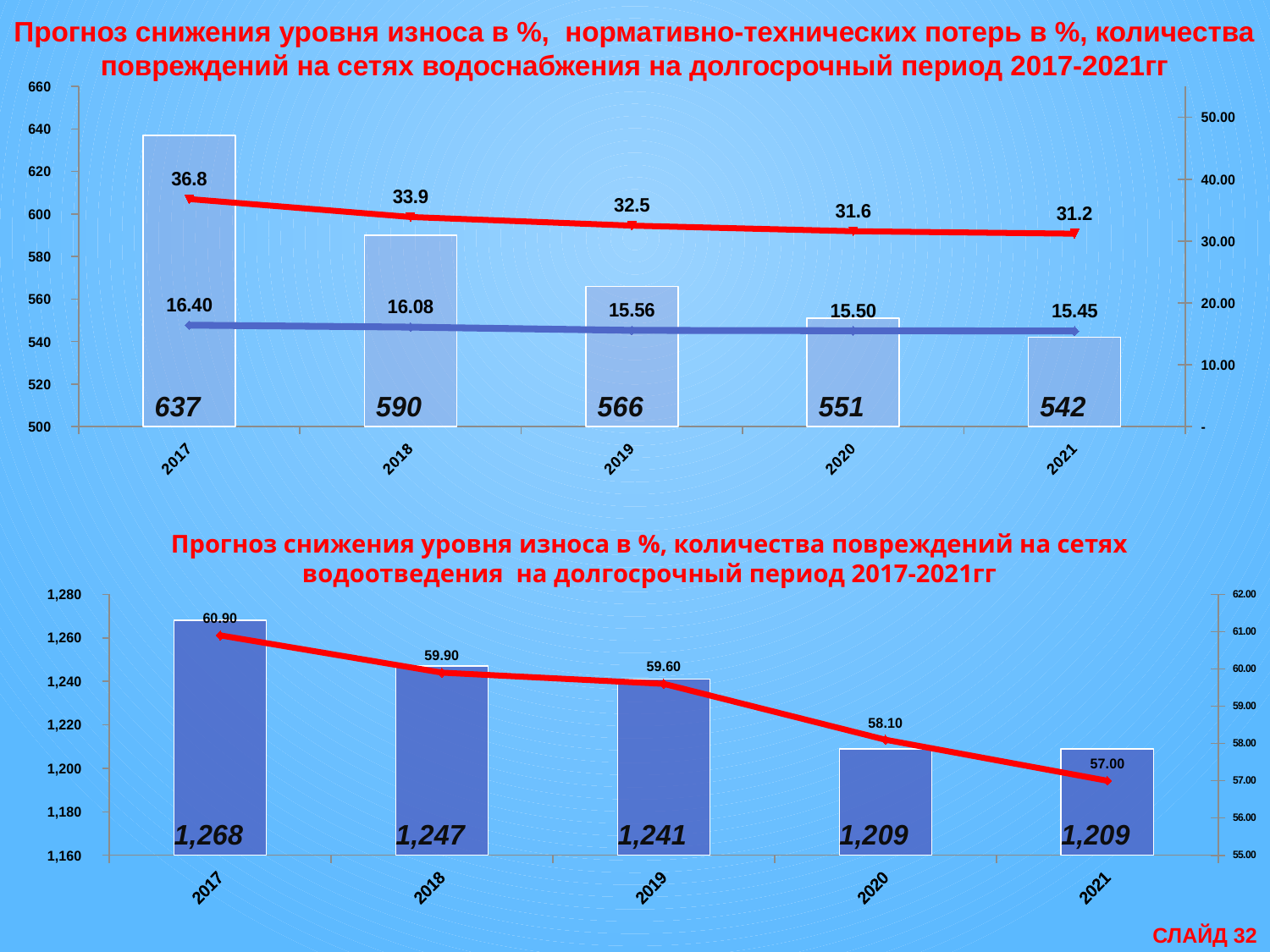
In the bottom chart (wastewater networks), which year has the highest bar value? 2017 In the top chart (water supply networks), what is the red line value for 2019? 32.5 In the top chart (water supply networks), which year has the lowest bar value? 2021 In the top chart (water supply networks), do the red line values rise or fall from 2017 to 2021? fall In the top chart (water supply networks), what is the bar value for 2017? 637 In the bottom chart (wastewater networks), what is the red line value for 2020? 58.10 In the bottom chart (wastewater networks), is the bar value for 2019 larger or smaller than the bar value for 2020? larger In the top chart (water supply networks), what is the difference between the bar values for 2017 and 2021? 95 In the top chart (water supply networks), what is the blue line value for 2021? 15.45 In the bottom chart (wastewater networks), what is the bar value for 2018? 1,247 In the bottom chart (wastewater networks), what is the difference between the red line values for 2017 and 2021? 3.90 In the top chart (water supply networks), how many years are shown on the x axis? 5